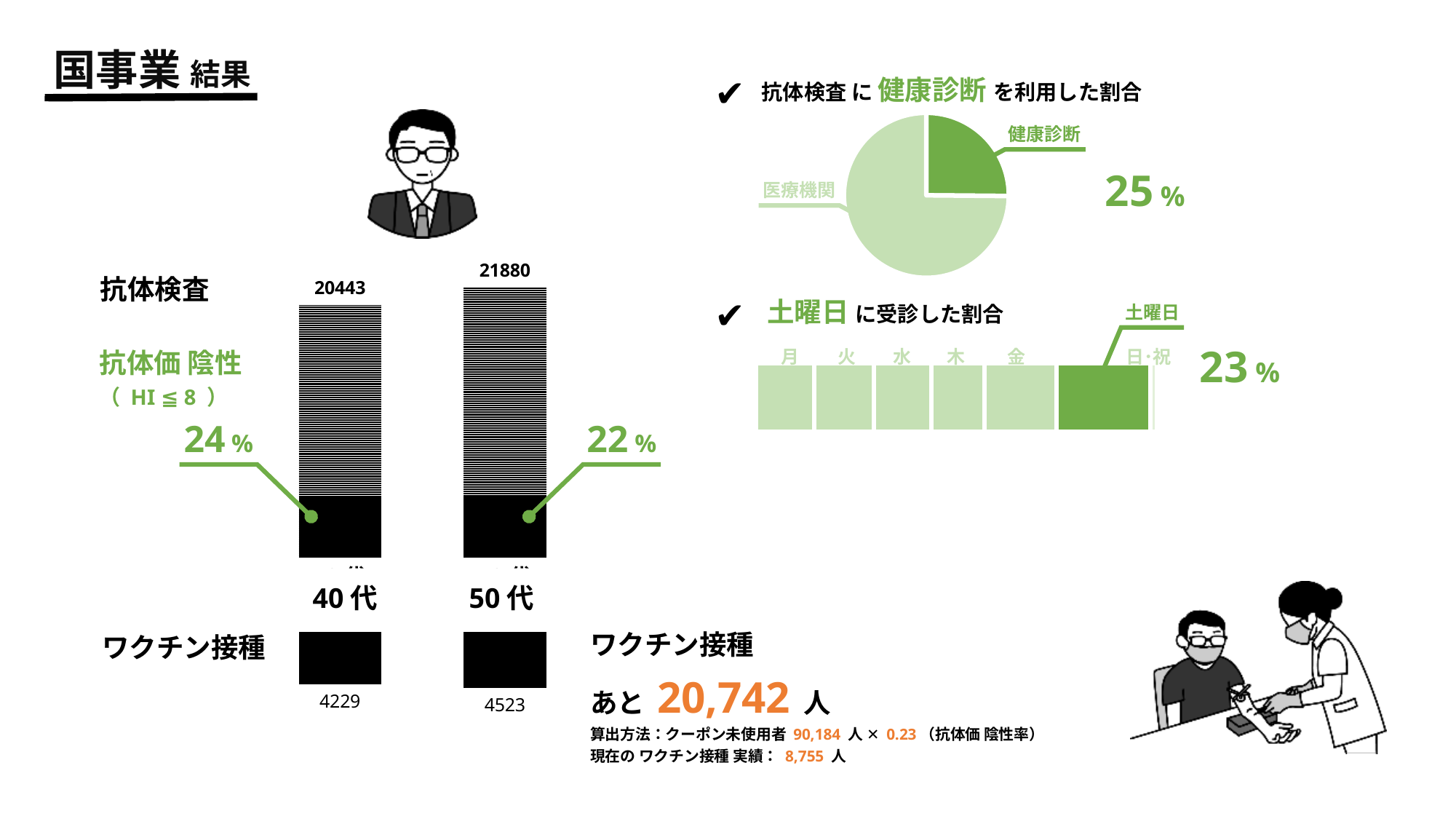
In the 抗体検査 bar chart, what percentage of 40代 is labelled 抗体価 陰性 (HI ≦ 8)? 24% In the 土曜日 に受診した割合 chart, what percentage is shown for 土曜日? 23% In the ワクチン接種 bars at the bottom left, what is the value for 40代? 4229 In the 抗体検査 bar chart, which age group has the higher number of antibody tests? 50代 In the ワクチン接種 bars at the bottom left, what is the value for 50代? 4523 In the 抗体検査 bar chart, what is the value for 40代? 20443 In the 抗体検査 bar chart, what is the value for 50代? 21880 In the ワクチン接種 bars at the bottom left, which age group has the larger value? 50代 In the pie chart at the top right, how many slices are there? 2 In the pie chart at the top right, what share is labelled 健康診断? 25% In the 抗体検査 bar chart, what is the difference between the 50代 and 40代 values? 1437 In the 抗体検査 bar chart, what percentage of 50代 is labelled 抗体価 陰性 (HI ≦ 8)? 22%